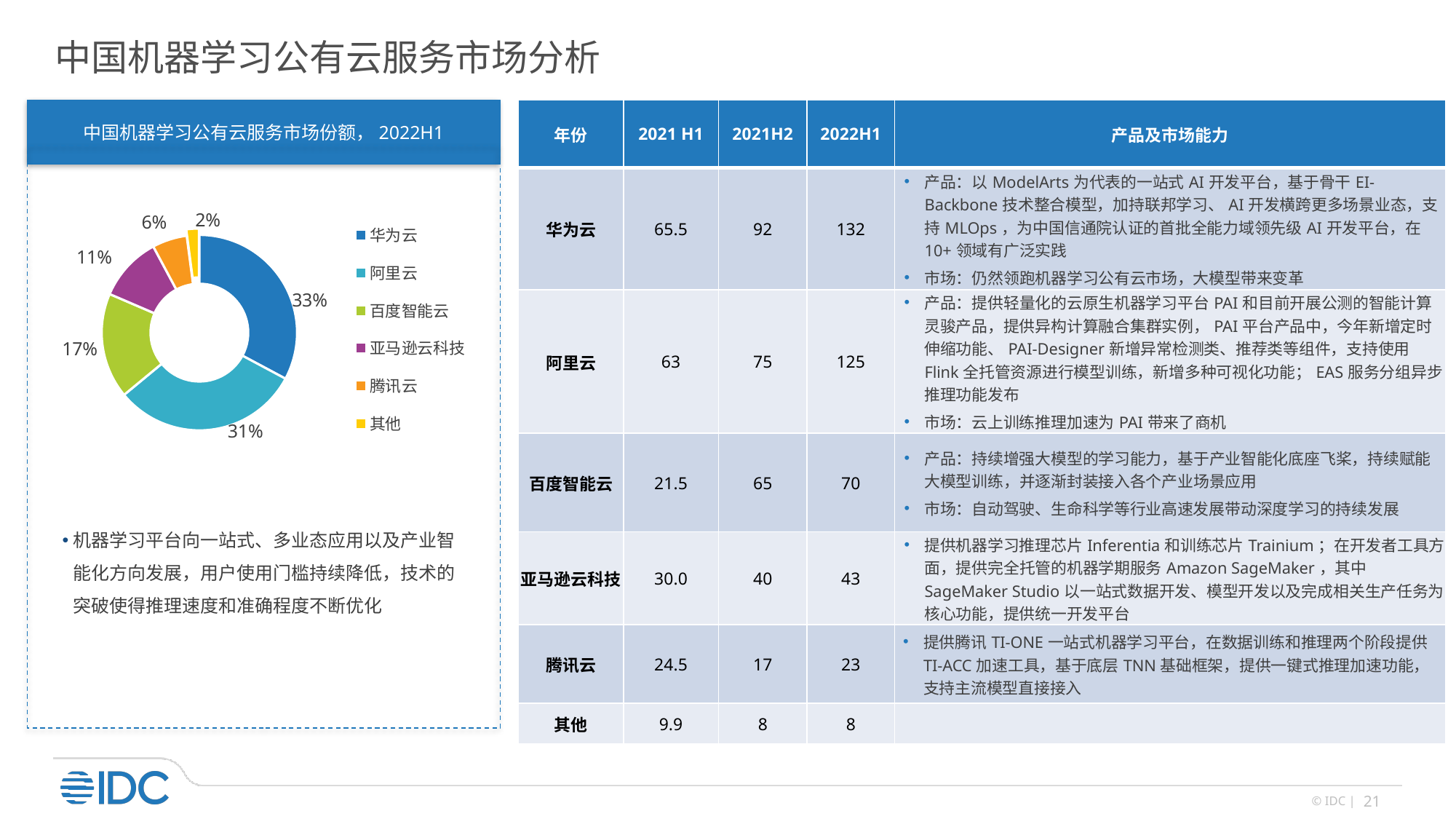
What is the difference in share between 百度智能云 and 亚马逊云科技 in the pie chart? 6% Which category has the largest slice in the pie chart? 华为云 How many categories are shown in the pie chart? 6 What type of chart is shown on the slide? Pie chart (donut) Which category has the smallest slice in the pie chart? 其他 What share of the pie chart does 腾讯云 hold? 6% What share of the pie chart does 阿里云 hold? 31% Which has a larger share in the pie chart, 亚马逊云科技 or 腾讯云? 亚马逊云科技 What is the difference in share between 华为云 and 阿里云 in the pie chart? 2% What share of the pie chart does 百度智能云 hold? 17% What is the title of the chart on the slide? 中国机器学习公有云服务市场份额，2022H1 What share of the pie chart does 华为云 hold? 33%